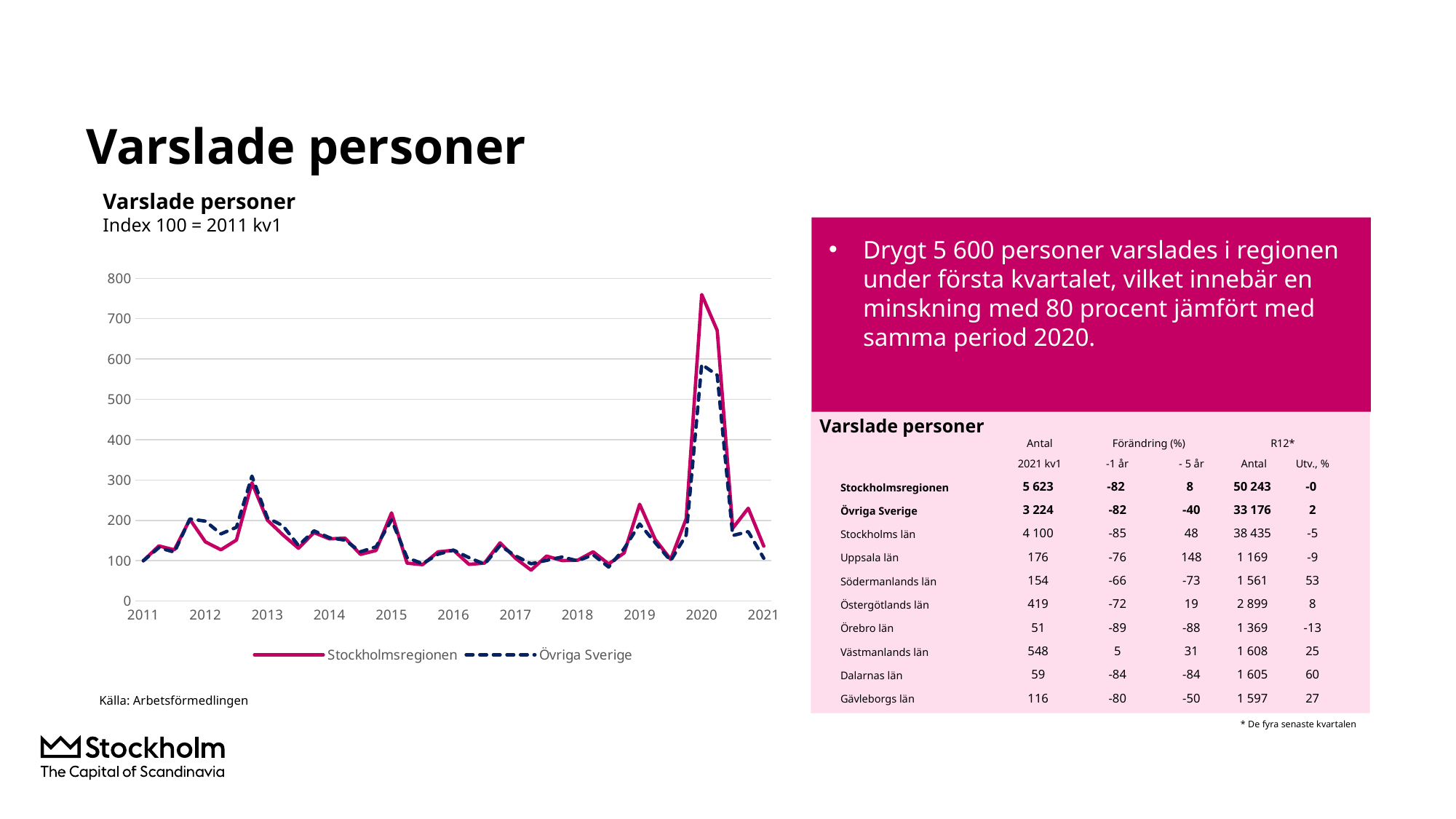
Is the value for Stockholmsregionen at its 2013 peak greater or less than 200? greater Do the values for Stockholmsregionen rise or fall from the 2020 peak to 2021? fall How many year labels are shown on the x axis of the chart? 11 What are the two series named in the chart legend? Stockholmsregionen and Övriga Sverige What is the index value of both series at the start of the chart in 2011 kv1? 100 Is the peak value for Övriga Sverige in 2020 greater or less than 500? greater Is the peak value for Stockholmsregionen in 2020 greater or less than 700? greater How many series does the legend of the chart list? 2 What kind of chart is shown on the slide? line chart At the 2020 peak, which series has the larger value, Stockholmsregionen or Övriga Sverige? Stockholmsregionen Which series reaches the highest peak in the chart? Stockholmsregionen What is the subtitle under the chart title 'Varslade personer'? Index 100 = 2011 kv1